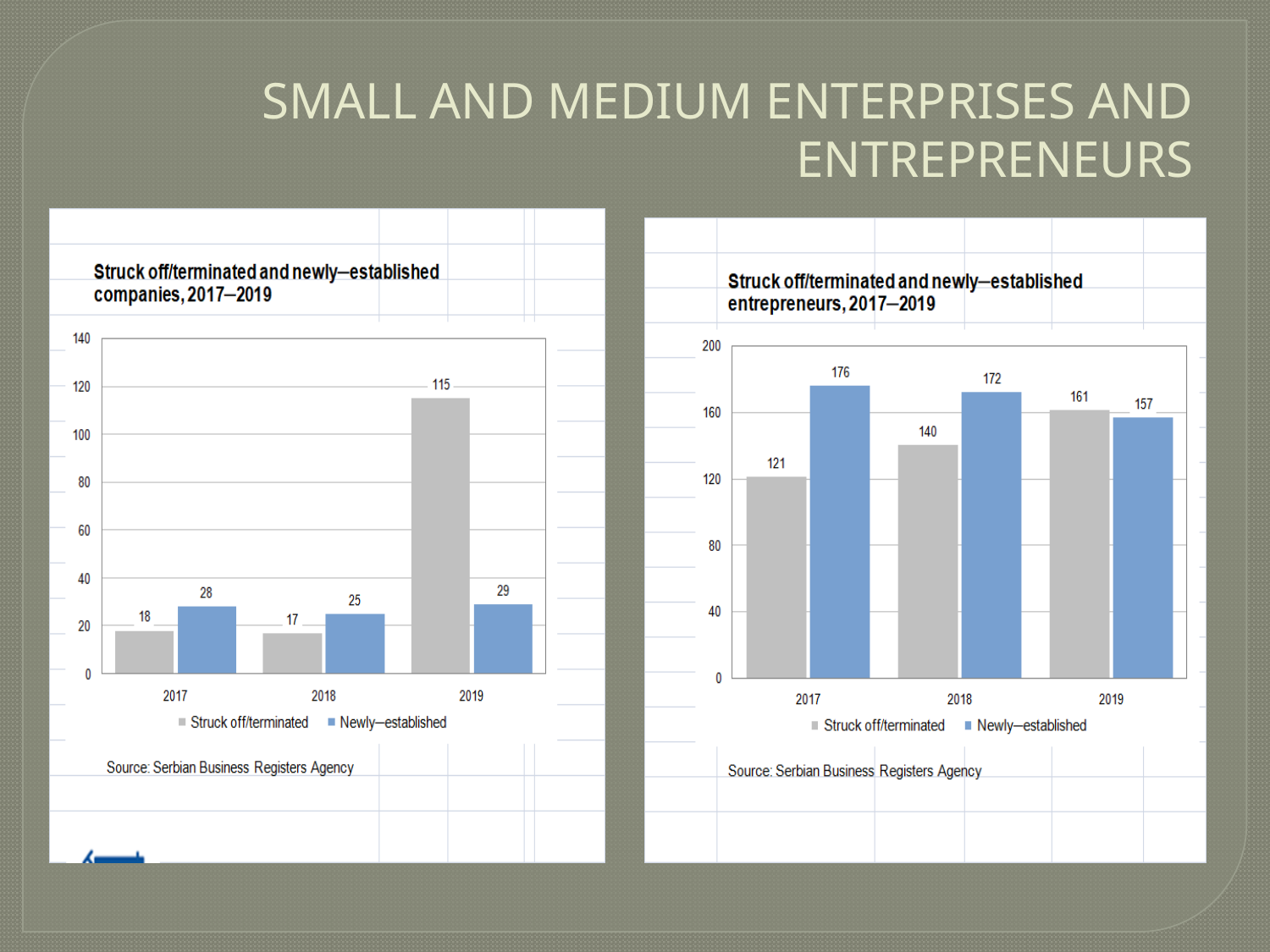
In the entrepreneurs chart (right), what is the difference between Newly-established and Struck off/terminated in 2018? 32 In the entrepreneurs chart (right), which year has the highest Struck off/terminated value? 2019 In the companies chart (left), which is larger in 2019: Struck off/terminated or Newly-established? Struck off/terminated In the companies chart (left), how many years are shown on the x axis? 3 In the companies chart (left), what is the value for Struck off/terminated in 2019? 115 What source is cited below the companies chart (left)? Serbian Business Registers Agency In the entrepreneurs chart (right), how many series does the legend list? 2 In the entrepreneurs chart (right), what is the value for Newly-established in 2017? 176 In the companies chart (left), which year has the lowest Struck off/terminated value? 2018 In the companies chart (left), what is the value for Newly-established in 2018? 25 In the entrepreneurs chart (right), does the Struck off/terminated value rise or fall from 2017 to 2019? Rise What kind of chart is the entrepreneurs chart (right)? Bar chart